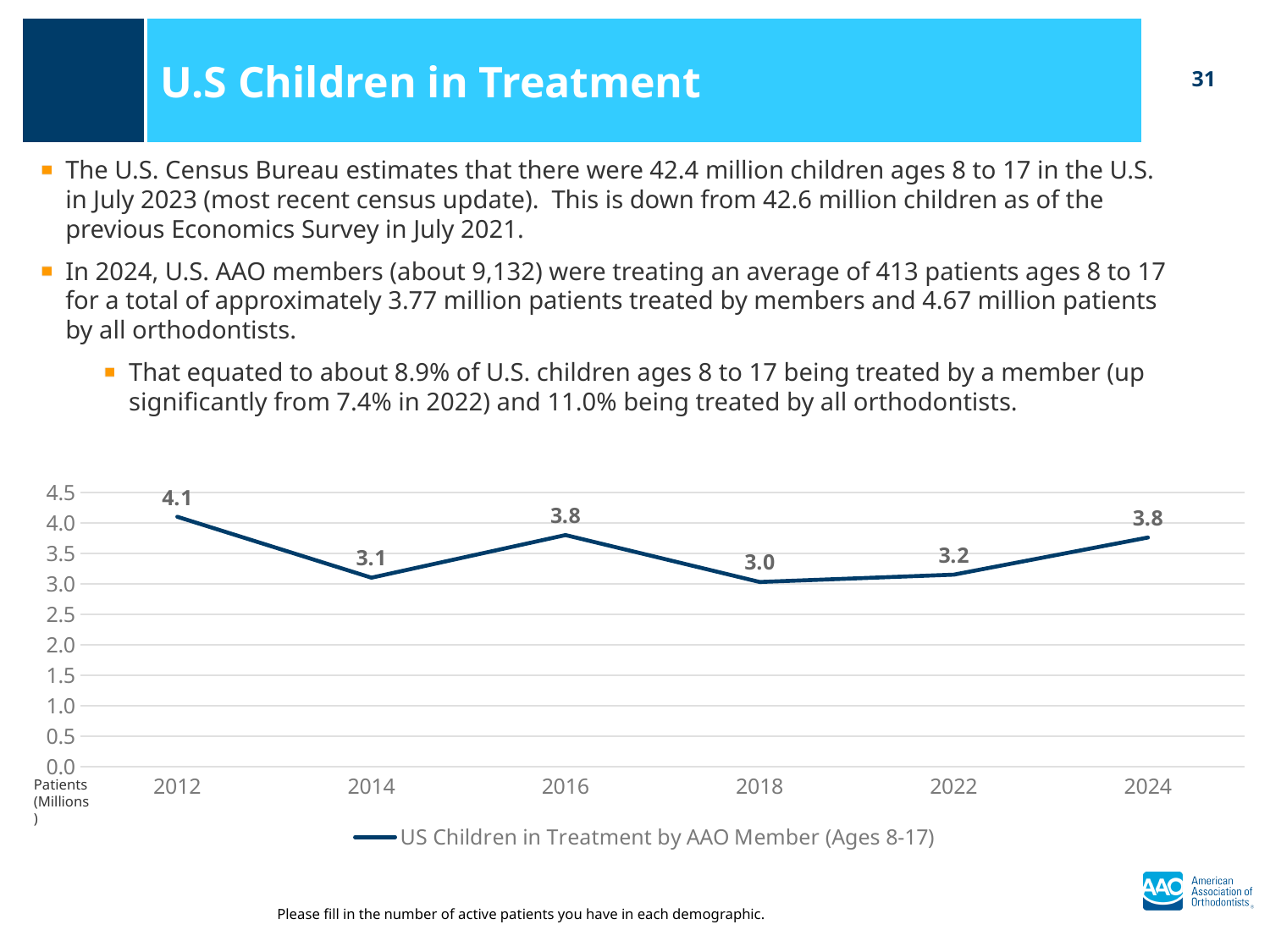
What is the difference between the values for 2012 and 2014? 1.0 What kind of chart is shown on the slide? line chart Which year has the lowest value in the chart? 2018 What is the value for 2024 in the chart? 3.8 What is the difference between the values for 2024 and 2022? 0.6 How many years are plotted in the chart? 6 What is the value for 2018 in the chart? 3.0 Which is larger, the value for 2016 or the value for 2018? 2016 Which year has the highest value in the chart? 2012 What is the legend entry for the plotted series? US Children in Treatment by AAO Member (Ages 8-17) What is the value for 2012 in the chart? 4.1 Is the value for 2014 greater or less than 3.5? less